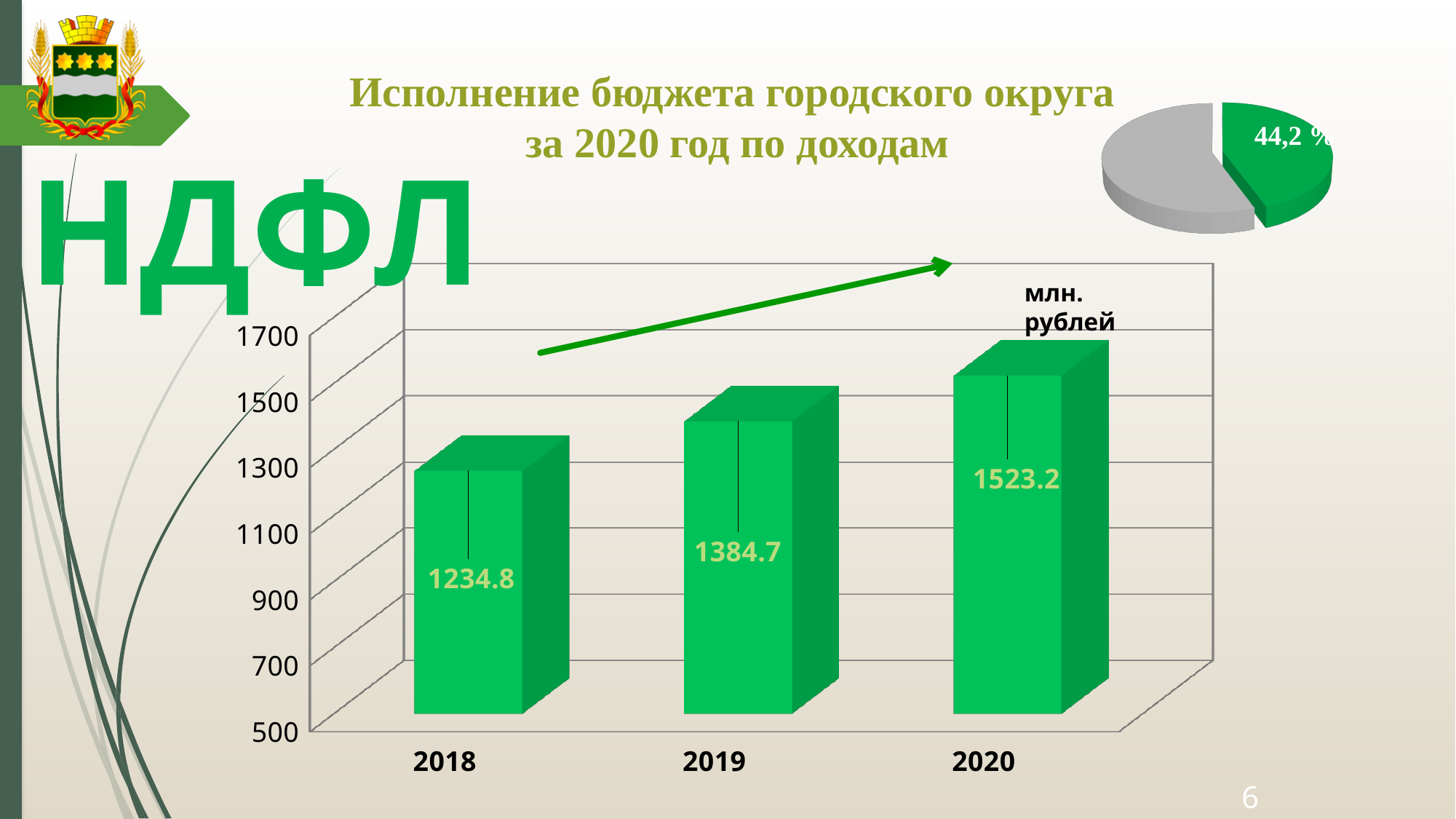
In the bar chart, which is larger, the value for 2019 or the value for 2020? 2020 In the bar chart, which year has the lowest value? 2018 In the pie chart at the top right, what percentage is shown for the green slice? 44,2 % In the bar chart, what is the value for 2020? 1523.2 In the bar chart, what is the value for 2019? 1384.7 In the bar chart, is the value for 2020 greater or less than 1500? greater In the bar chart, what is the difference between the values for 2019 and 2018? 149.9 Do the values in the bar chart rise or fall from 2018 to 2020? rise In the bar chart, which year has the highest value? 2020 How many years are shown in the bar chart? 3 In the bar chart, what is the difference between the values for 2020 and 2018? 288.4 In the bar chart, what is the value for 2018? 1234.8